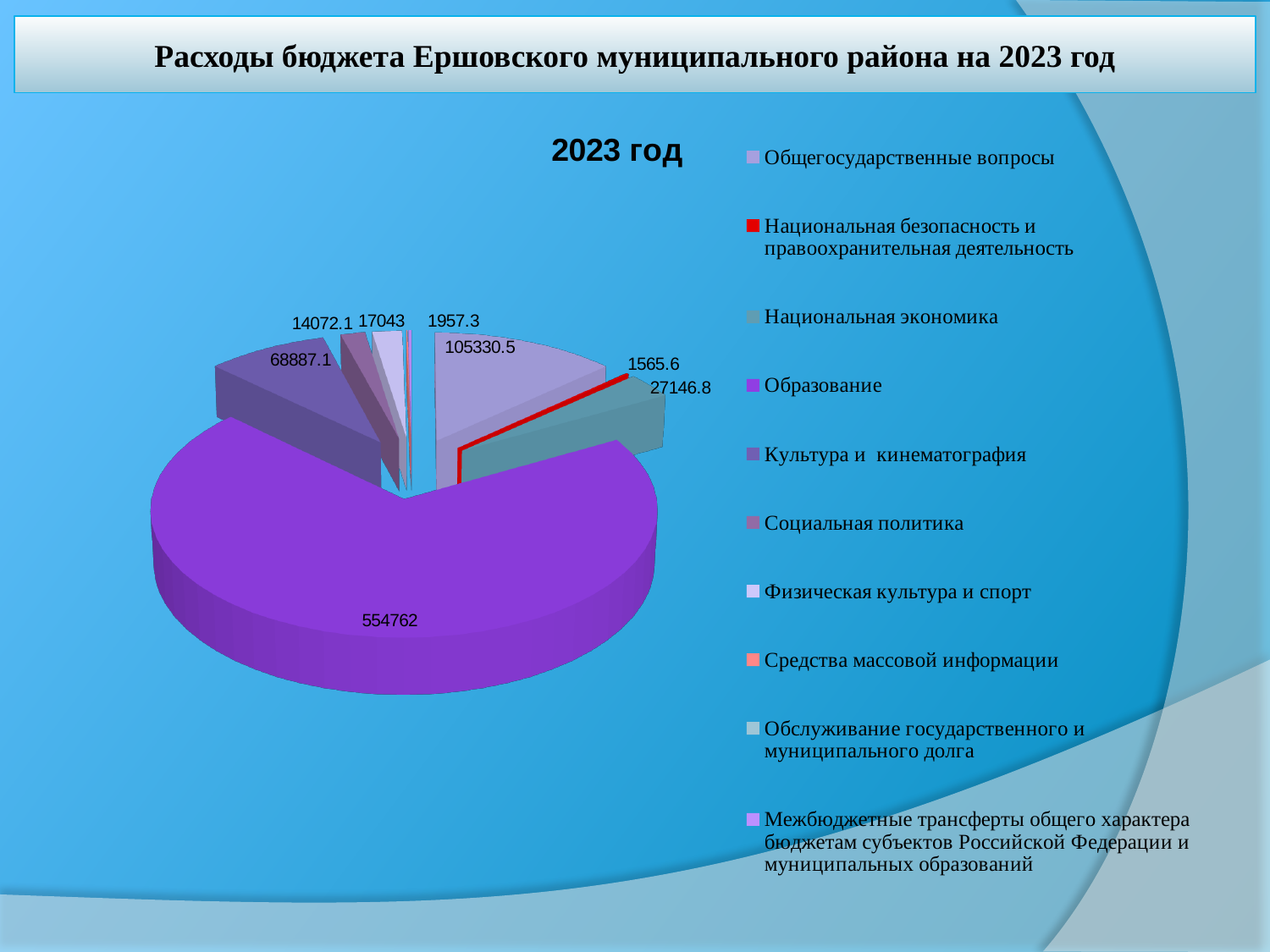
What is the value for Общегосударственные вопросы in the pie chart? 105330.5 What is the value for Национальная безопасность и правоохранительная деятельность in the pie chart? 1565.6 What is the difference between the values for Общегосударственные вопросы and Культура и кинематография? 36443.4 How many categories does the legend of the pie chart list? 10 What is the value for Образование in the pie chart? 554762 What is the title shown above the pie chart? 2023 год What is the value for Культура и кинематография in the pie chart? 68887.1 Which category has the largest slice in the pie chart? Образование What kind of chart is shown on the slide? Pie chart Which is larger in the pie chart: Общегосударственные вопросы or Культура и кинематография? Общегосударственные вопросы What is the difference between the values for Национальная экономика and Национальная безопасность и правоохранительная деятельность? 25581.2 What is the value for Национальная экономика in the pie chart? 27146.8